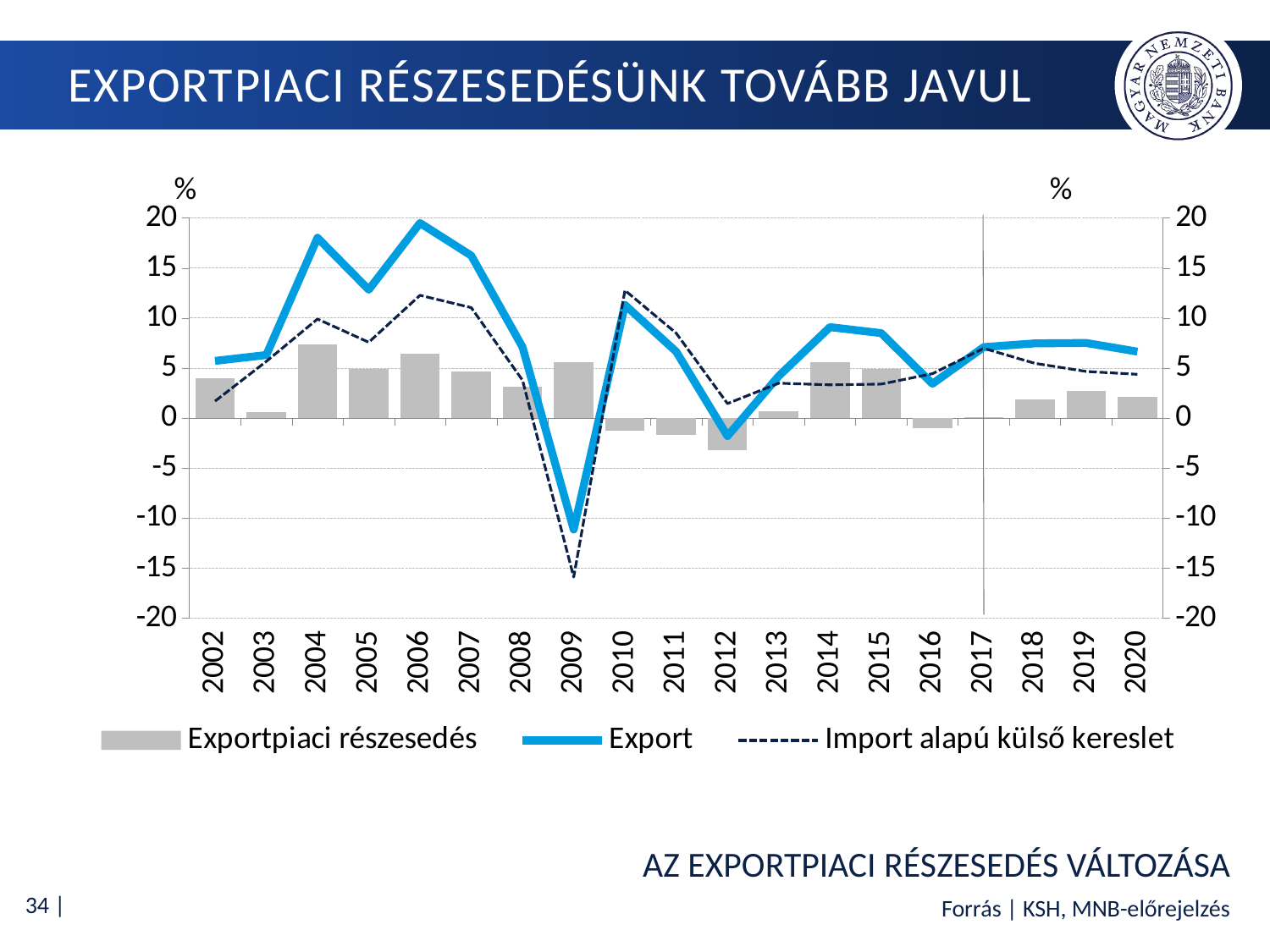
In which year is the Exportpiaci részesedés bar the tallest? 2004 In which year is the Exportpiaci részesedés bar the lowest (most negative)? 2012 Does the Export line rise or fall between 2006 and 2009? fall Is the Export value for 2004 greater or less than 15? greater Is the Import alapú külső kereslet value for 2009 greater or less than -10? less How many series does the legend list? 3 In which year does the Import alapú külső kereslet line reach its lowest value? 2009 In which year does the Export line reach its lowest value? 2009 In which year does the Export line reach its highest value? 2006 How many years are shown on the x axis? 19 In 2006, which is larger: the Export value or the Import alapú külső kereslet value? Export What kind of chart is shown on the slide? A combined bar and line chart